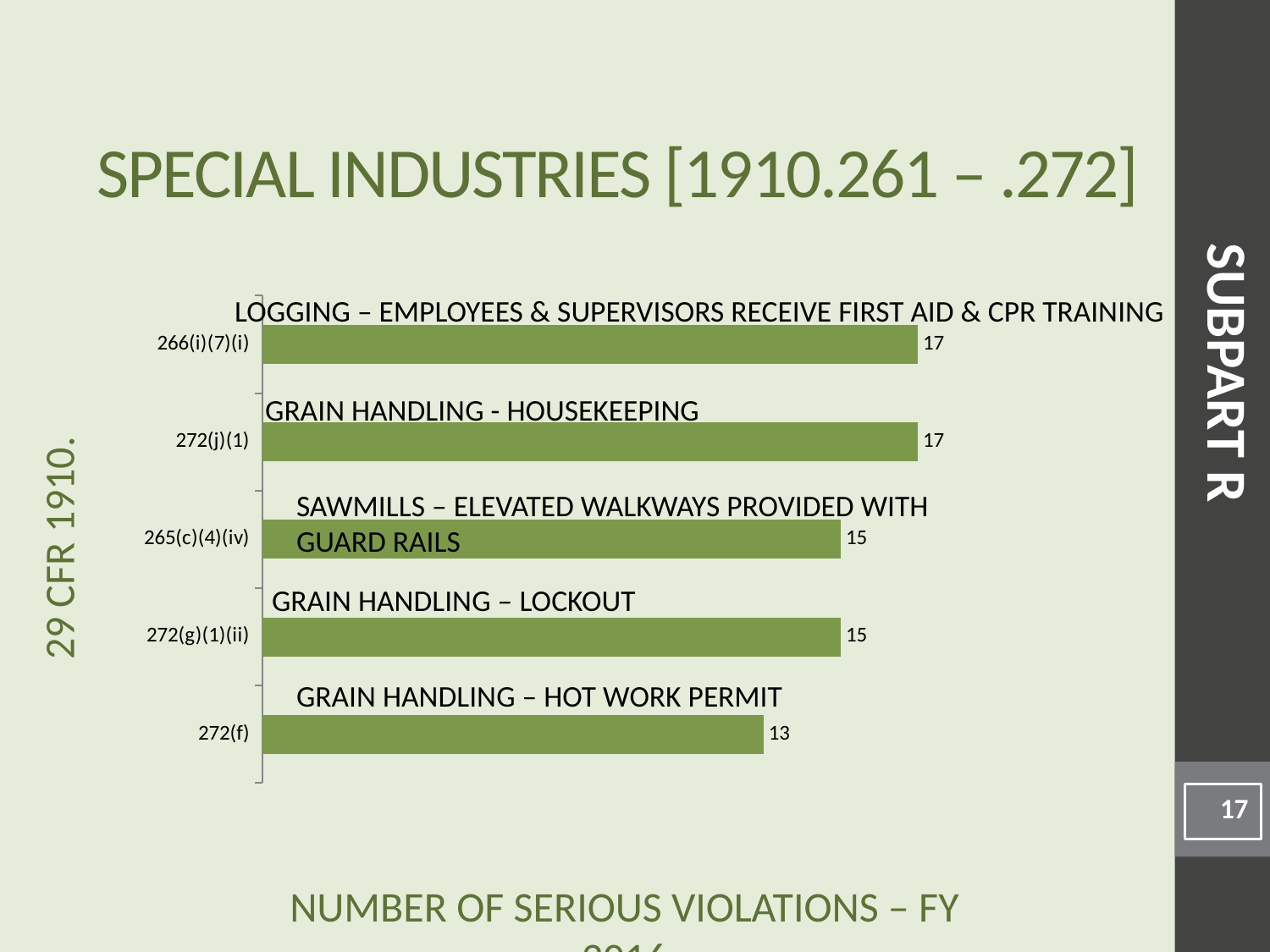
Which standard does the bar labeled 'GRAIN HANDLING - HOUSEKEEPING' correspond to? 272(j)(1) How many categories are shown in the chart? 5 Which category has the lowest number of serious violations? 272(f) What is the value shown for 272(g)(1)(ii)? 15 Which is larger, the value for 272(j)(1) or the value for 272(g)(1)(ii)? 272(j)(1) What is the difference between the values for 266(i)(7)(i) and 265(c)(4)(iv)? 2 What is the number of serious violations for 266(i)(7)(i)? 17 What is the difference between the values for 272(j)(1) and 272(f)? 4 What is the value shown for 265(c)(4)(iv)? 15 What is the number of serious violations for 272(f)? 13 What kind of chart is shown on the slide? Bar chart What is the total of the values for 272(j)(1), 272(g)(1)(ii) and 272(f)? 45